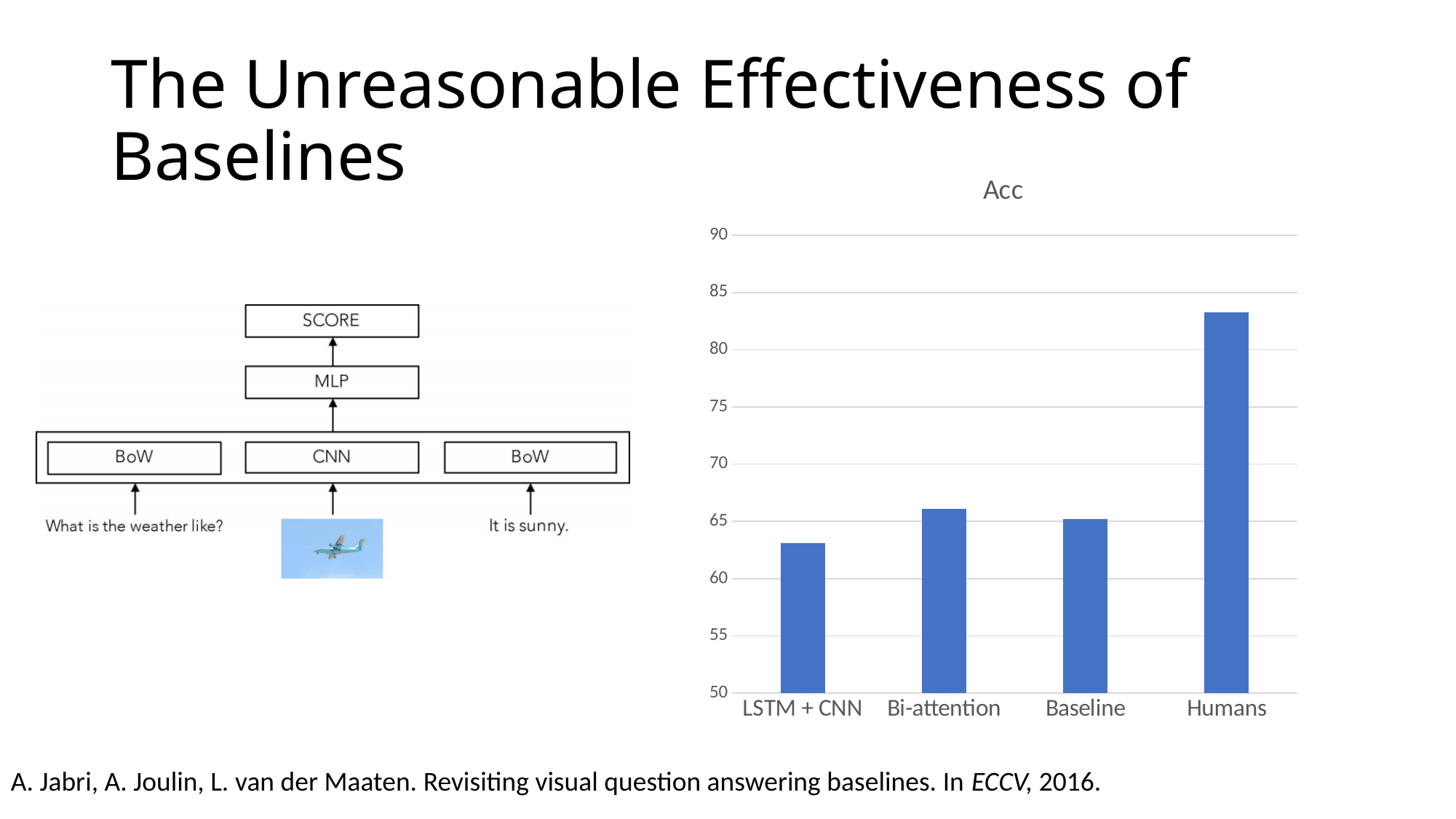
Is the value for LSTM + CNN greater or less than 65? less What is the title of the chart? Acc Is the value for Humans greater or less than 85? less Which category has the lowest value in the chart? LSTM + CNN Which is larger, the value for Bi-attention or the value for LSTM + CNN? Bi-attention Is the value for Humans greater or less than 80? greater Which is larger, the value for Humans or the value for Baseline? Humans How many categories are shown on the x axis of the chart? 4 Which category has the highest value in the chart? Humans What kind of chart is shown on the slide? bar chart